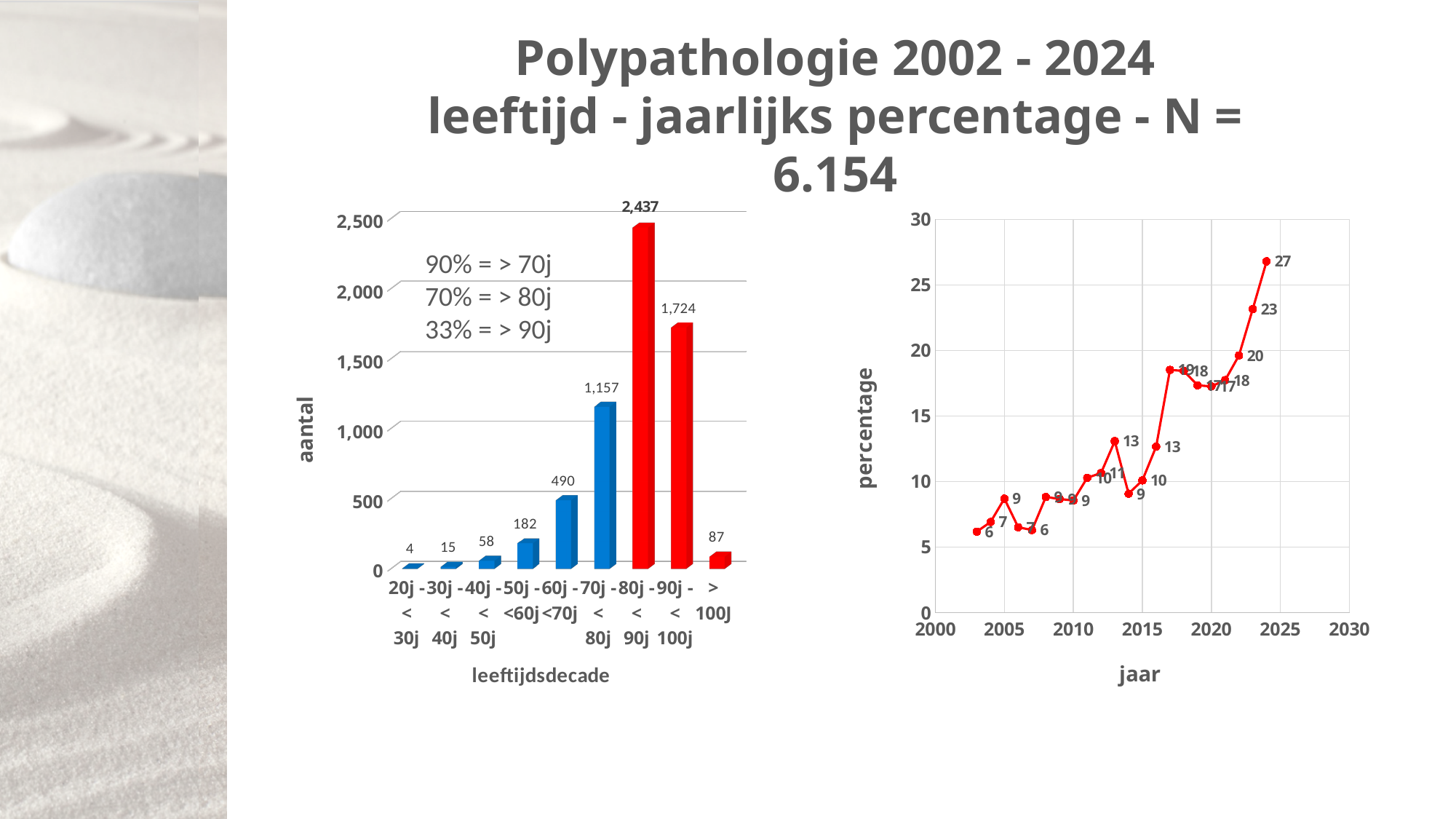
On the left bar chart, which age decade has the highest count? 80j - < 90j On the left bar chart, what is the value for the 80j - < 90j age decade? 2,437 On the left bar chart, which is larger: the value for 70j - < 80j or for 90j - < 100j? 90j - < 100j How many age decade categories are shown on the left bar chart? 9 What kind of chart is the left chart on the slide? bar chart On the left bar chart, what is the difference between the 80j - < 90j and 90j - < 100j values? 713 On the right line chart, what is the percentage value for the last point, in 2024? 27 What is the label of the x axis on the right line chart? jaar On the left bar chart, which age decade has the lowest count? 20j - < 30j On the left bar chart, what is the value for the 60j - < 70j age decade? 490 On the right line chart, do the percentage values generally rise or fall from 2003 to 2024? rise On the right line chart, what is the highest percentage value shown? 27